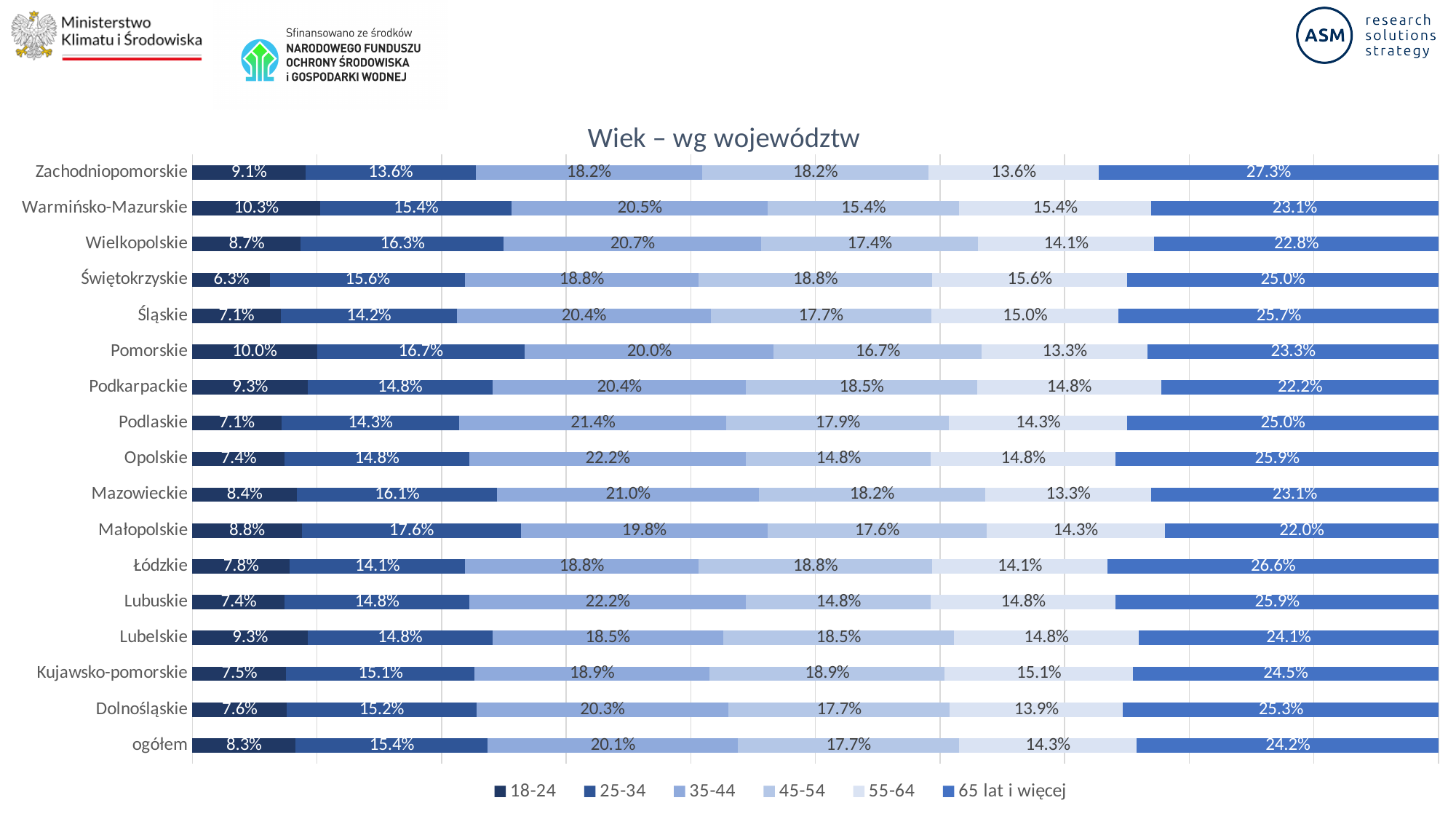
What is the value for the '18-24' series for Pomorskie? 10.0% Which is larger: the '35-44' value for Opolskie or for Mazowieckie? Opolskie Which category has the lowest value in the '18-24' series? Świętokrzyskie What is the title of the chart? Wiek – wg województw How many series does the legend list? 6 What is the value for the '65 lat i więcej' series for Zachodniopomorskie? 27.3% What is the total of the stacked bar for ogółem? 100.0% What kind of chart is shown on the slide? Stacked bar chart Which category has the highest value in the '65 lat i więcej' series? Zachodniopomorskie What is the value for the '35-44' series for ogółem? 20.1% How many categories are shown on the vertical axis of the chart? 17 What is the difference between the '65 lat i więcej' value and the '18-24' value for Zachodniopomorskie? 18.2%